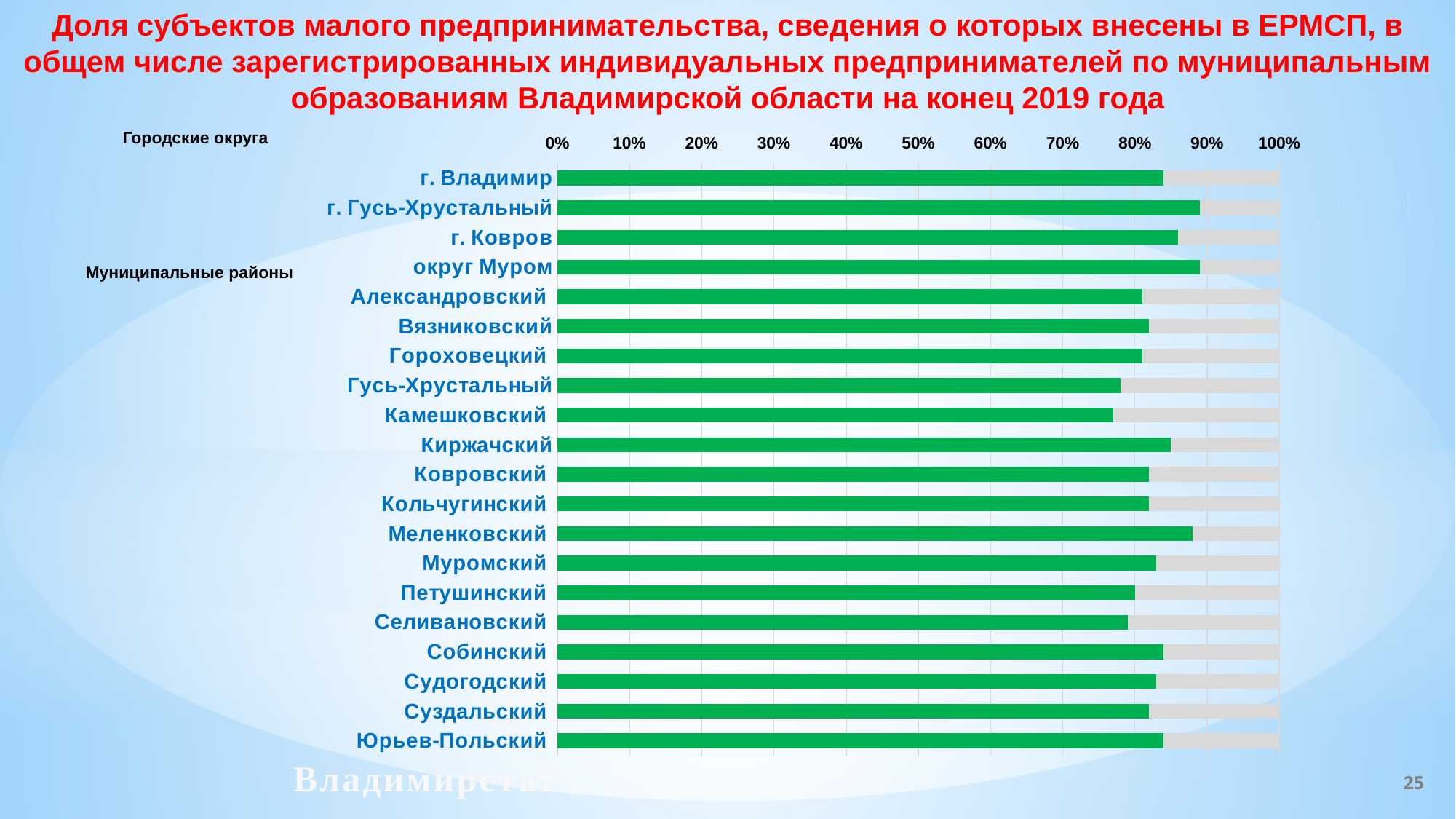
Which has the larger value, Меленковский or Петушинский? Меленковский Is the value for Селивановский greater or less than 90%? less What colour are the bars in the chart? green How many municipal entities (categories) are plotted in the chart? 20 Is the value for Меленковский greater or less than 80%? greater Which has the larger value, г. Гусь-Хрустальный or Камешковский? г. Гусь-Хрустальный What is the highest value shown on the horizontal axis of the chart? 100% Is the value for Камешковский greater or less than 80%? less What kind of chart is shown on the slide? bar chart